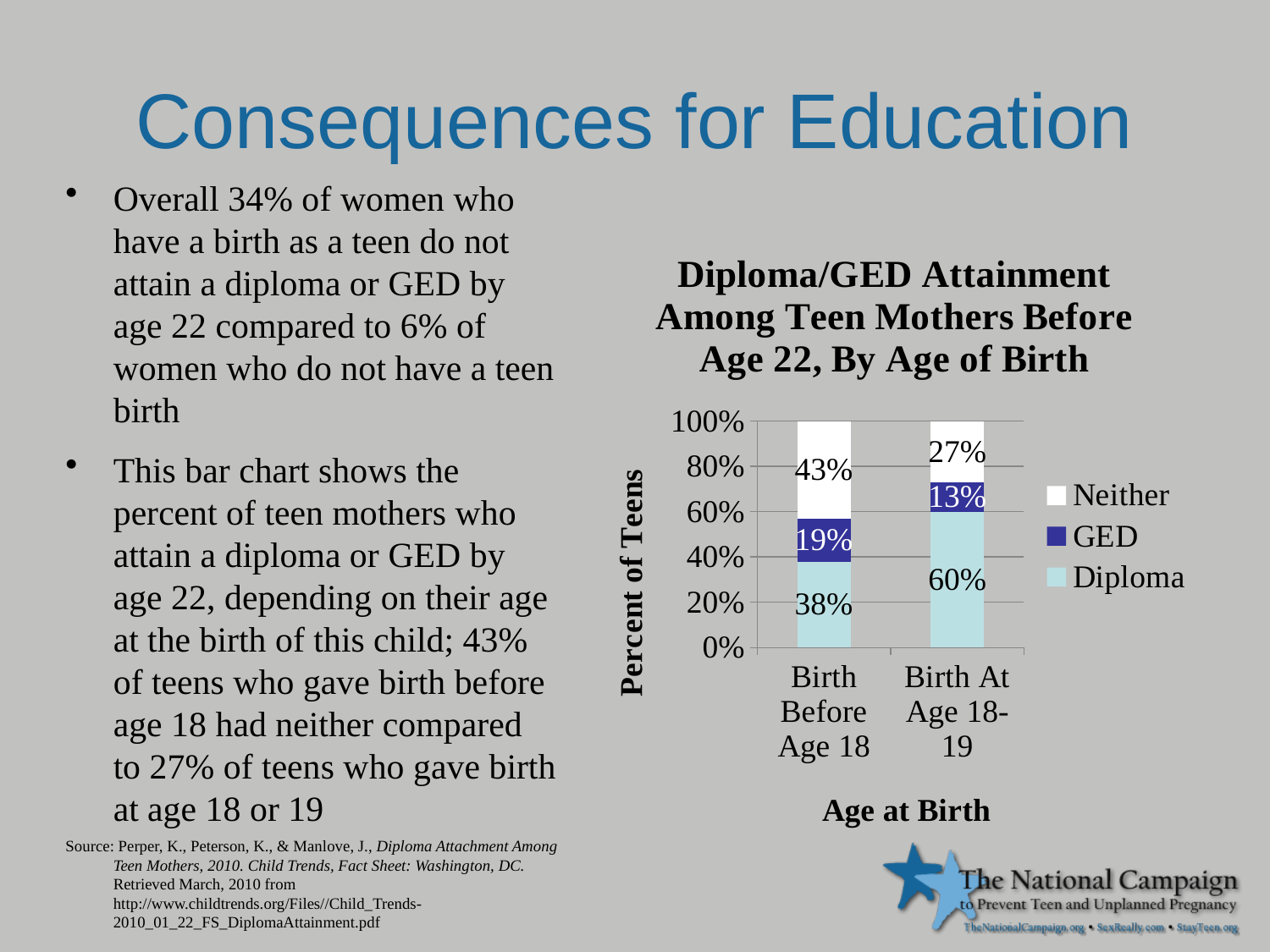
How many series does the legend list? 3 How many age-at-birth categories are shown on the x axis? 2 What is the value for Diploma in the Birth At Age 18-19 bar? 60% Which age-at-birth category has the higher Neither percentage? Birth Before Age 18 What is the difference between the Diploma percentages for Birth At Age 18-19 and Birth Before Age 18? 22% What is the difference between the Neither percentages for Birth Before Age 18 and Birth At Age 18-19? 16% What percentage of teens who gave birth at age 18-19 attained a GED? 13% What is the value for Neither in the Birth Before Age 18 bar? 43% What percentage of teens who gave birth before age 18 attained a diploma? 38% What type of chart is shown on the slide? Stacked bar chart What is the value for Neither in the Birth At Age 18-19 bar? 27% Which age-at-birth category has the higher Diploma percentage? Birth At Age 18-19